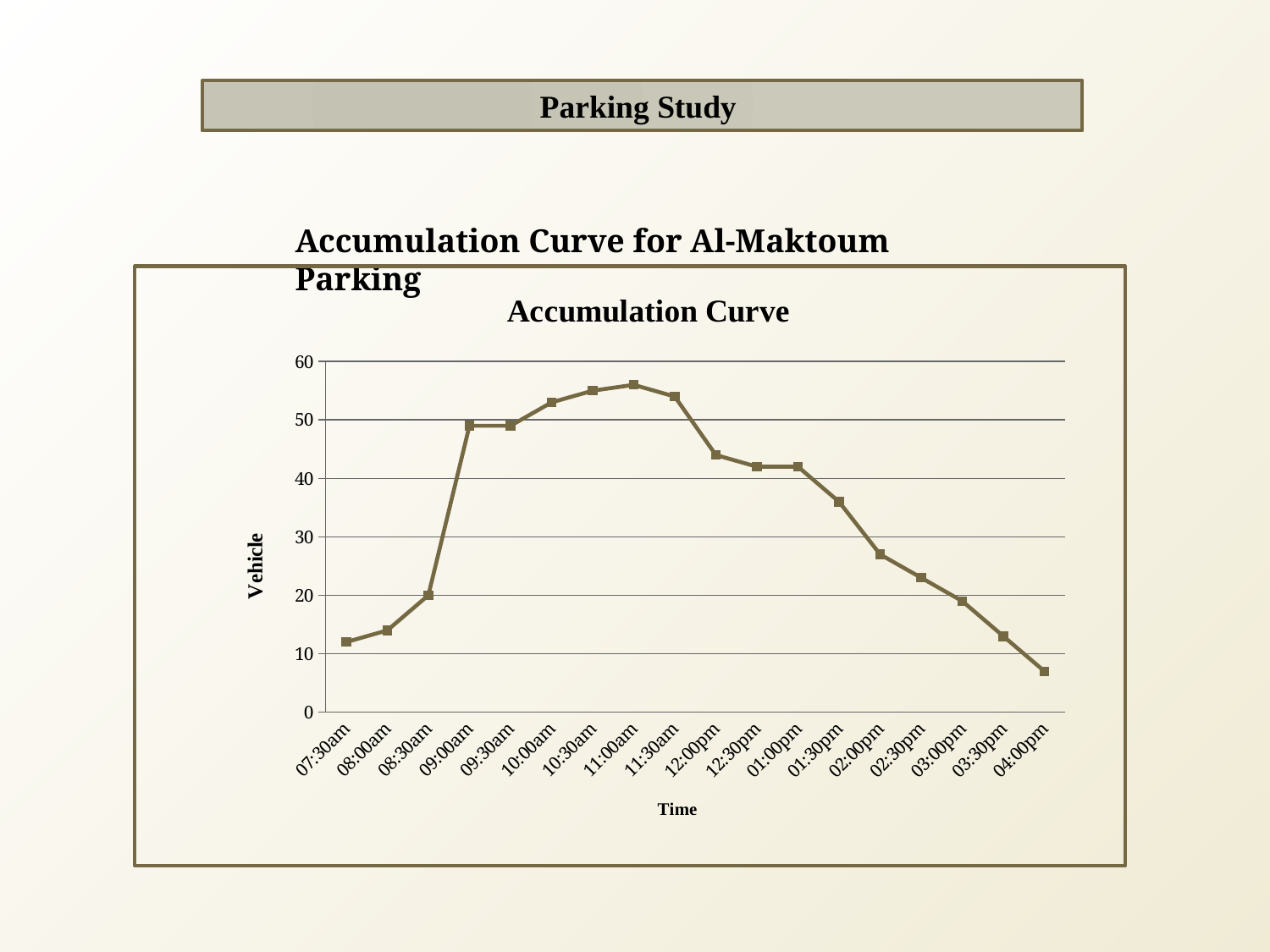
At which time does the accumulation curve reach its highest value? 11:00am Is the value at 04:00pm greater or less than 10? less What is the label on the vertical axis of the chart? Vehicle Is the value at 01:30pm greater or less than 30? greater What is the title shown inside the chart area? Accumulation Curve At which time does the accumulation curve reach its lowest value? 04:00pm Is the value at 02:00pm greater or less than 30? less What type of chart is shown on the slide? line chart How many time points are plotted on the x axis? 18 Which has the higher number of vehicles, 10:00am or 02:00pm? 10:00am How does the number of vehicles change from 11:00am to 04:00pm? It falls